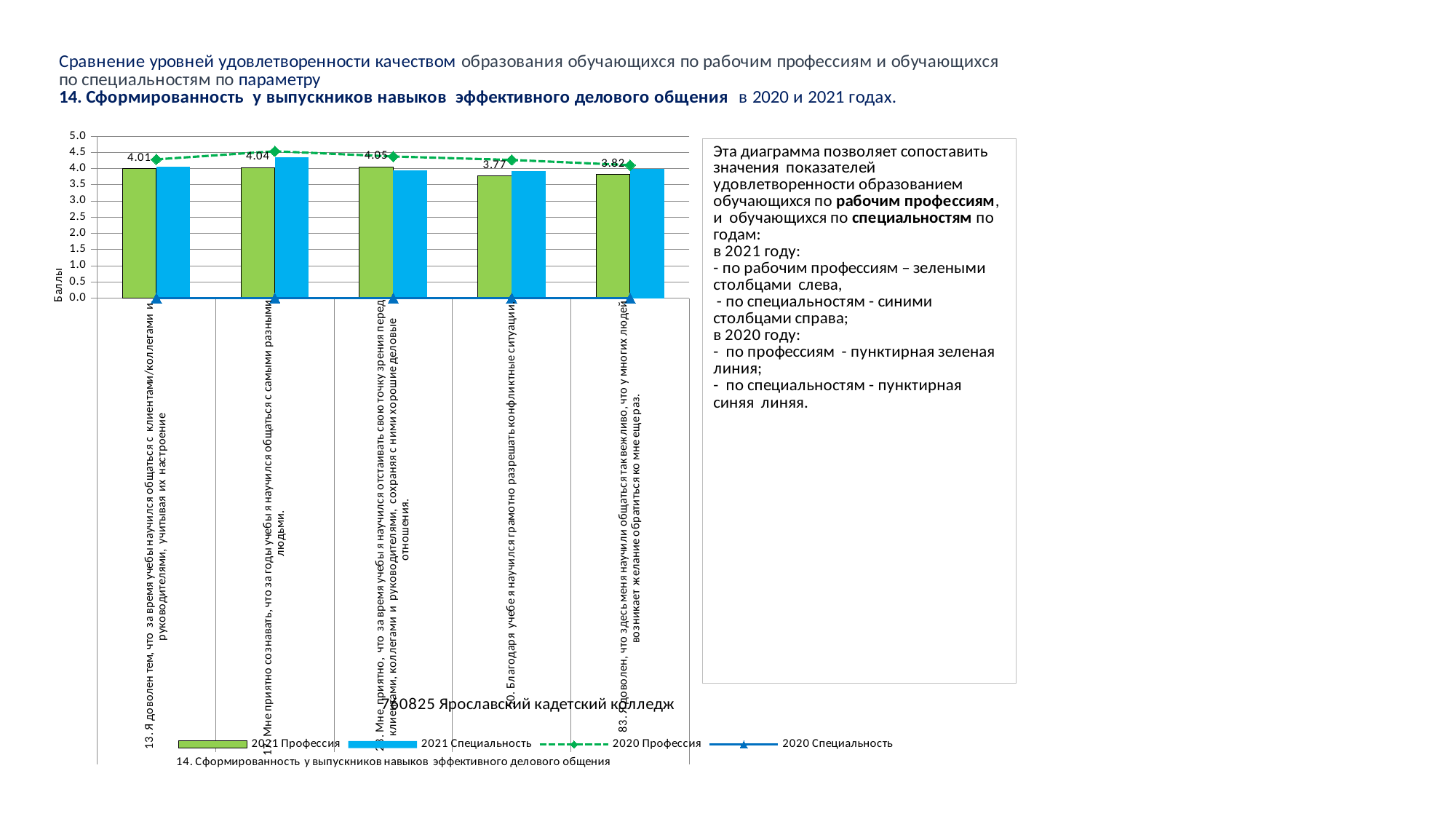
How many series does the chart legend list? 4 What kind of chart is shown on the slide? A bar chart combined with line series What is the 2021 Профессия value for the last category (83. Я доволен, что здесь меня научили общаться так вежливо)? 3.82 What is the title of the vertical axis of the chart? Баллы How many categories are plotted along the x axis of the chart? 5 What is the 2021 Профессия value for the first category (13. Я доволен тем, что за время учебы научился общаться с клиентами/коллегами и руководителями)? 4.01 What is the difference between the highest and lowest 2021 Профессия values (4.05 and 3.77)? 0.28 Is the 2021 Специальность value for the second category greater or less than 4.0? greater Which category has the highest 2021 Профессия value? The third category (Мне приятно, что за время учебы я научился отстаивать свою точку зрения), 4.05 For the second category, which is larger: the 2021 Профессия bar or the 2021 Специальность bar? 2021 Специальность Which category has the lowest 2021 Профессия value? Благодаря учебе я научился грамотно разрешать конфликтные ситуации, 3.77 What is the 2021 Профессия value for the category 'Благодаря учебе я научился грамотно разрешать конфликтные ситуации'? 3.77